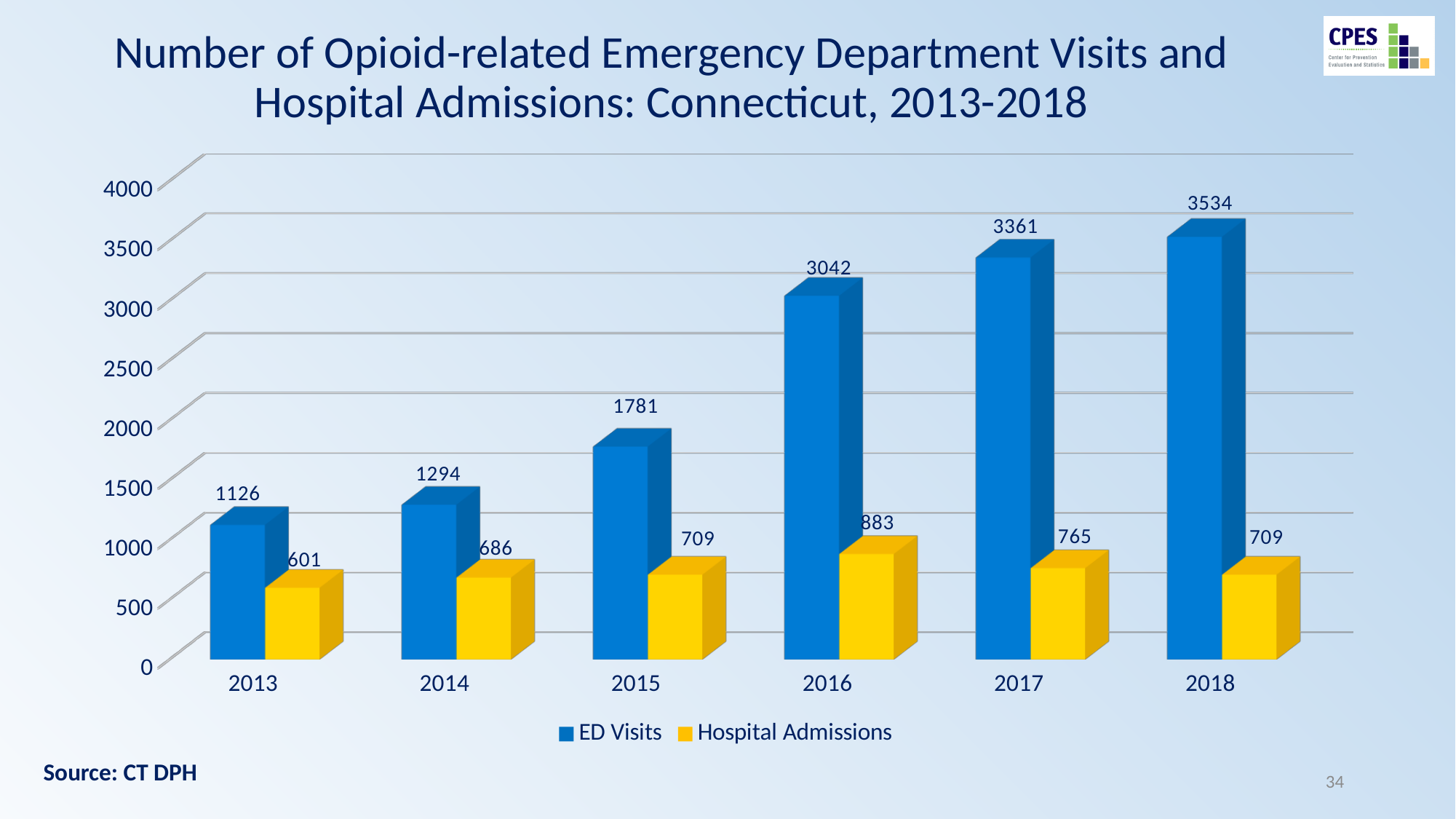
Which year has the highest number of Hospital Admissions? 2016 What is the difference between ED Visits and Hospital Admissions in 2015? 1072 How many series does the legend list? 2 Is the value for ED Visits in 2015 greater or less than 2000? less What is the number of Hospital Admissions in 2014? 686 What is the difference between ED Visits in 2018 and ED Visits in 2017? 173 What is the number of ED Visits in 2016? 3042 Which year has the lowest number of Hospital Admissions? 2013 Which is larger: Hospital Admissions in 2017 or Hospital Admissions in 2018? 2017 How many years are shown on the x axis? 6 Which year has the highest number of ED Visits? 2018 What kind of chart is shown on the slide? bar chart